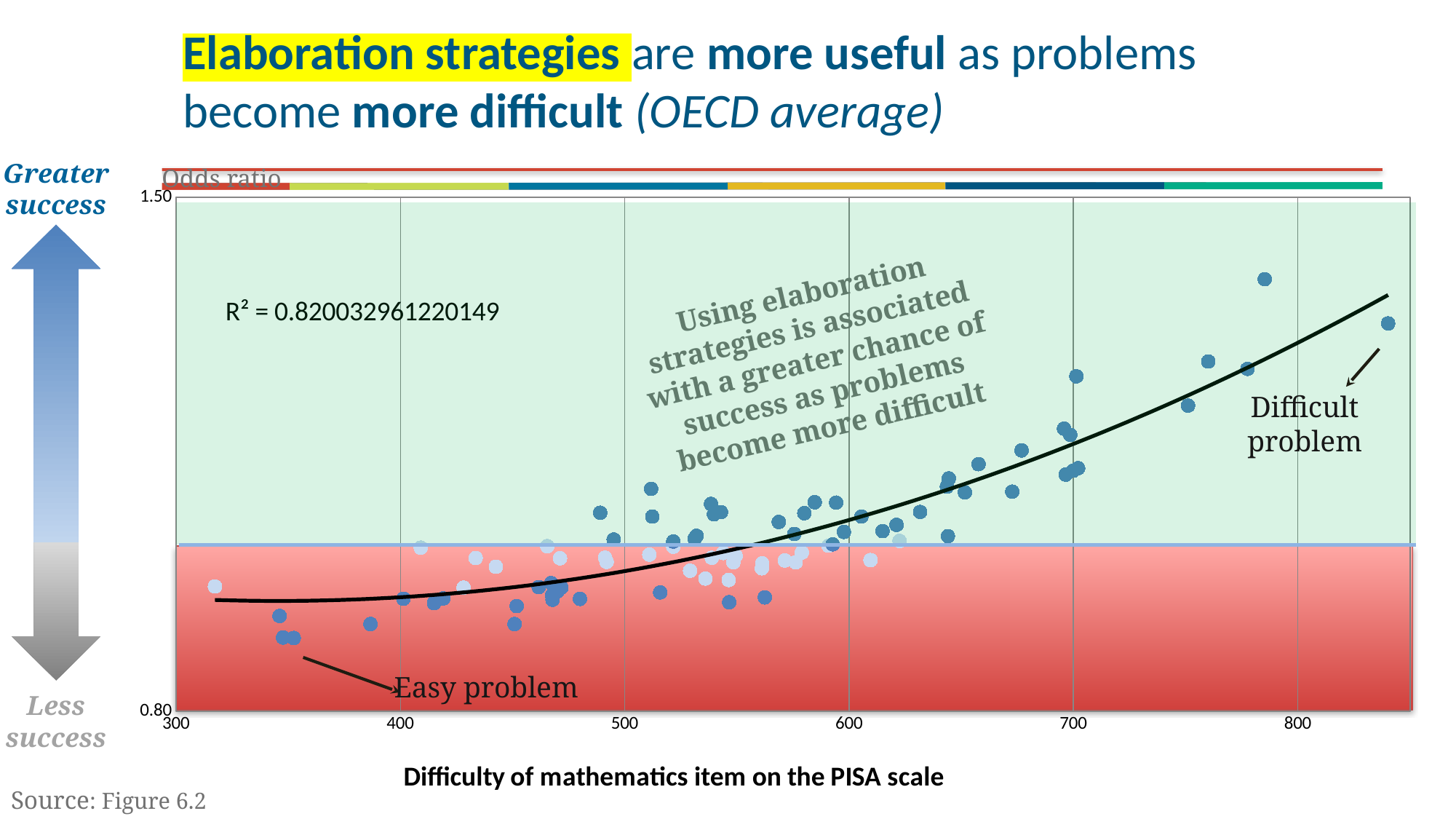
Which figure is cited as the source of the chart? Figure 6.2 Which has the higher odds ratio: the point labelled 'Difficult problem' or the point labelled 'Easy problem'? Difficult problem What is the highest value shown on the y axis? 1.50 What is the lowest value shown on the x axis? 300 Does the odds ratio generally rise or fall as the difficulty of the mathematics item increases along the x axis? rise What is the label of the y axis? Odds ratio What is the R² value printed on the chart? R² = 0.820032961220149 What is the lowest value shown on the y axis? 0.80 What is the label of the x axis? Difficulty of mathematics item on the PISA scale Is the difficulty of the point labelled 'Difficult problem' greater or less than 800 on the PISA scale? greater Is the difficulty of the point labelled 'Easy problem' greater or less than 400 on the PISA scale? less What kind of chart is shown on the slide? scatter chart